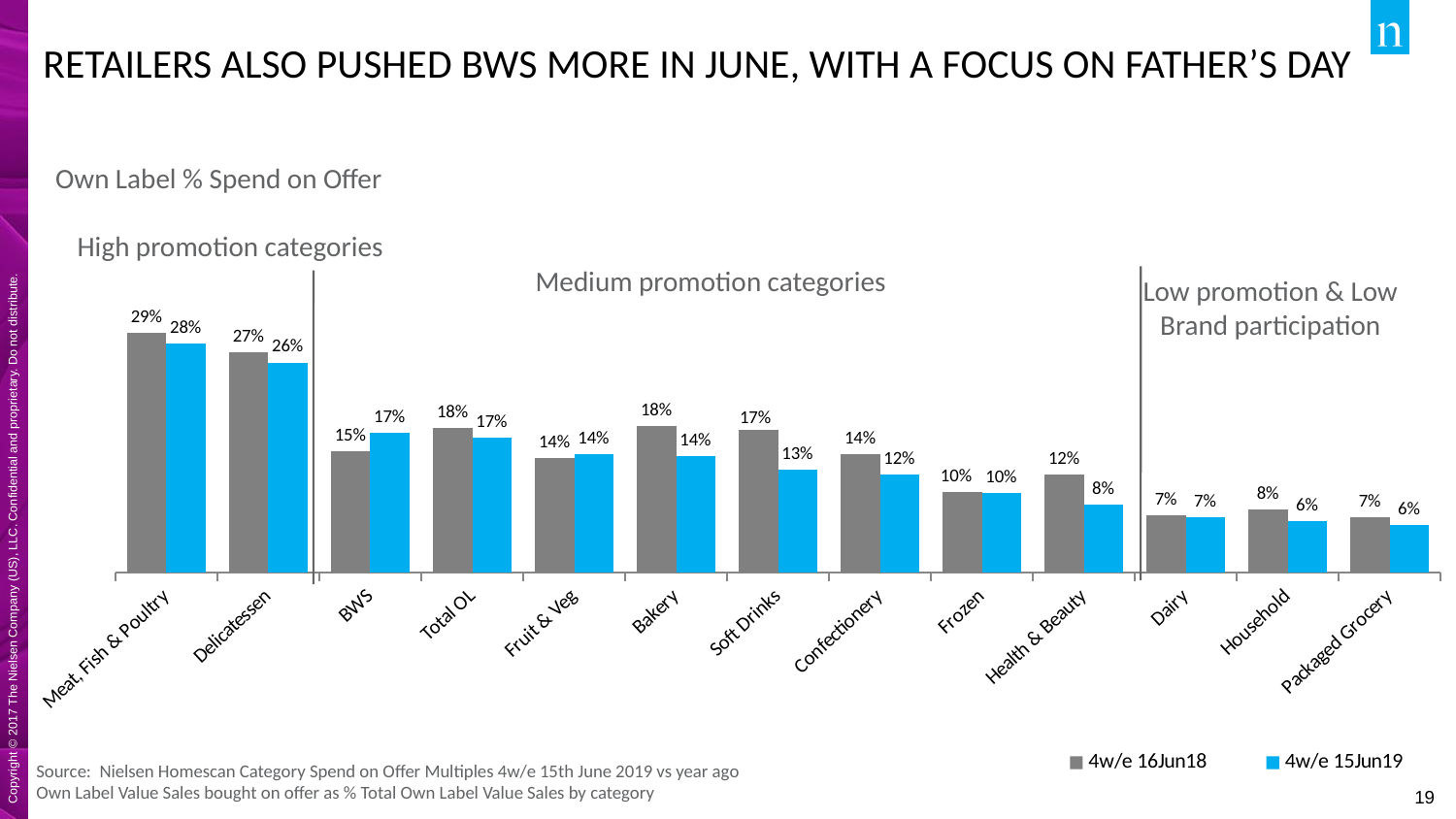
What is the value for Health & Beauty in the 4w/e 15Jun19 series? 8% How many series does the legend list? 2 What is the value for Meat, Fish & Poultry in the 4w/e 15Jun19 series? 28% What is the value for BWS in the 4w/e 16Jun18 series? 15% Which category has the lowest value in the 4w/e 16Jun18 series? Dairy and Packaged Grocery (7%) Which category has the highest value in the 4w/e 16Jun18 series? Meat, Fish & Poultry What kind of chart is shown on the slide? Bar chart What is the value for Soft Drinks in the 4w/e 16Jun18 series? 17% For BWS, which series has the larger value: 4w/e 16Jun18 or 4w/e 15Jun19? 4w/e 15Jun19 How many categories are shown on the x axis? 13 What is the difference between the 4w/e 16Jun18 and 4w/e 15Jun19 values for Bakery? 4 percentage points Which categories are grouped under 'High promotion categories'? Meat, Fish & Poultry and Delicatessen